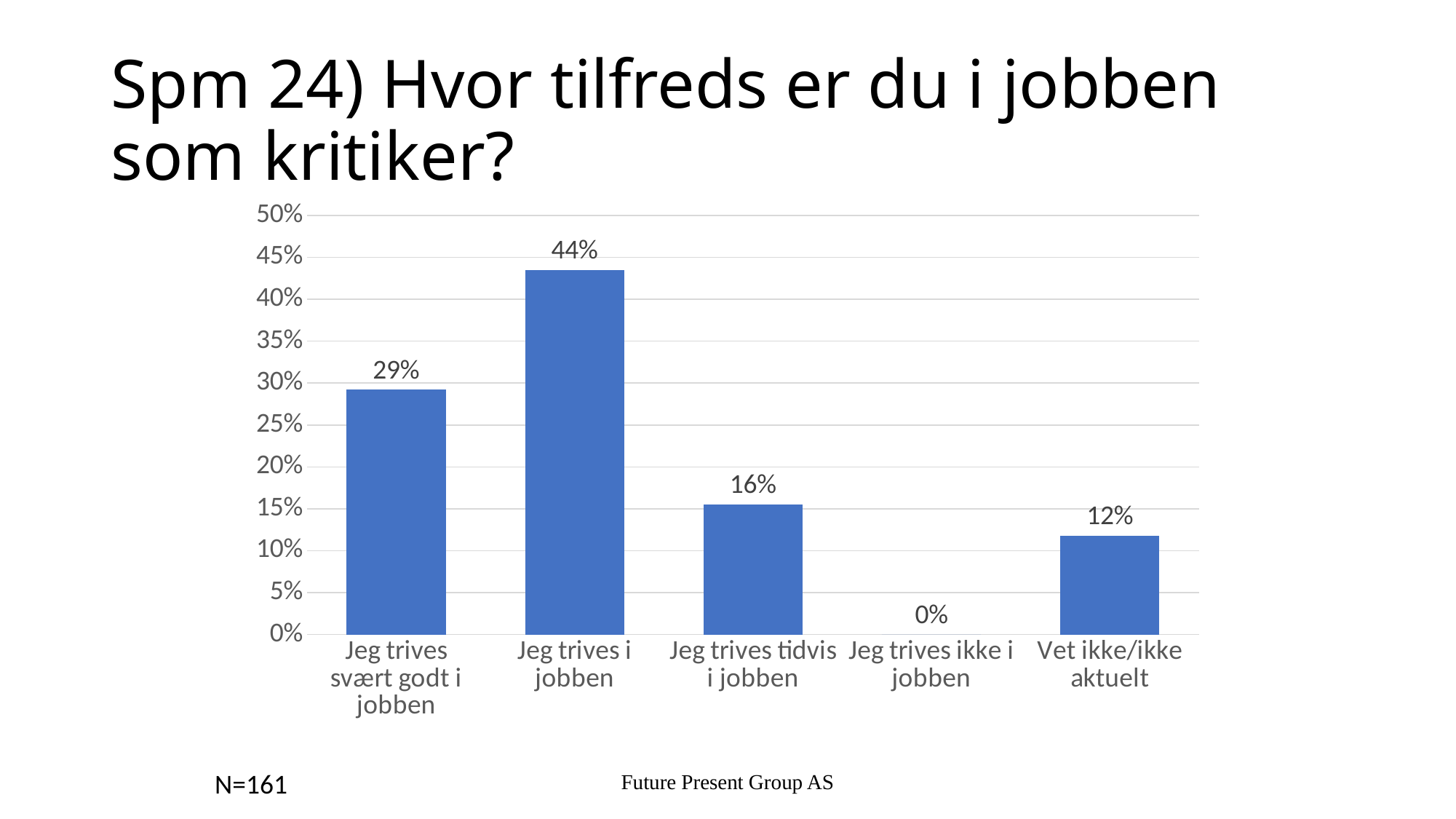
Which is larger, the value for "Jeg trives tidvis i jobben" or the value for "Vet ikke/ikke aktuelt"? Jeg trives tidvis i jobben Which category has the highest value? Jeg trives i jobben What is the value for "Jeg trives ikke i jobben"? 0% What kind of chart is shown on the slide? Bar chart What is the value for "Vet ikke/ikke aktuelt"? 12% What is the value for "Jeg trives i jobben"? 44% What is the difference between the values for "Jeg trives i jobben" and "Jeg trives svært godt i jobben"? 15% Which category has the lowest value? Jeg trives ikke i jobben What sample size (N) is stated on the slide? N=161 Is the value for "Jeg trives svært godt i jobben" greater or less than 25%? greater How many categories are shown on the x axis? 5 What is the value for "Jeg trives svært godt i jobben"? 29%